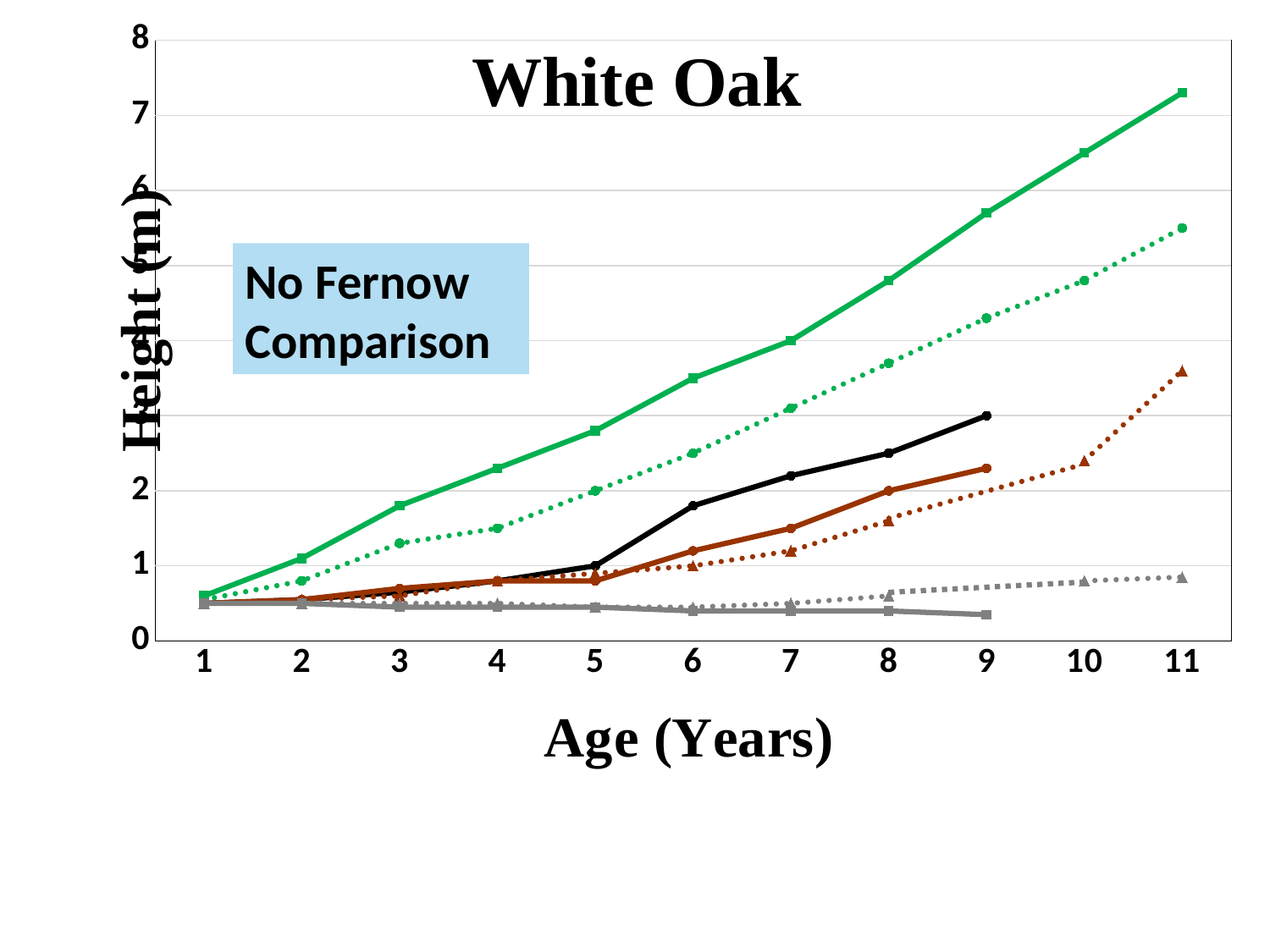
Is the value of the dotted green line at age 11 greater or less than 6? less Is the value of the solid green line at age 11 greater or less than 7? greater What kind of chart is shown on the slide? line chart Is the value of the solid gray line at age 9 greater or less than 1? less Which line has the lowest value at age 9? the solid gray line Which line has the highest value at age 11? the solid green line Does the solid green line rise or fall as age increases from 1 to 11? rise What text appears in the blue box on the chart? No Fernow Comparison How many age values are shown along the x axis? 11 What is the title of the chart? White Oak